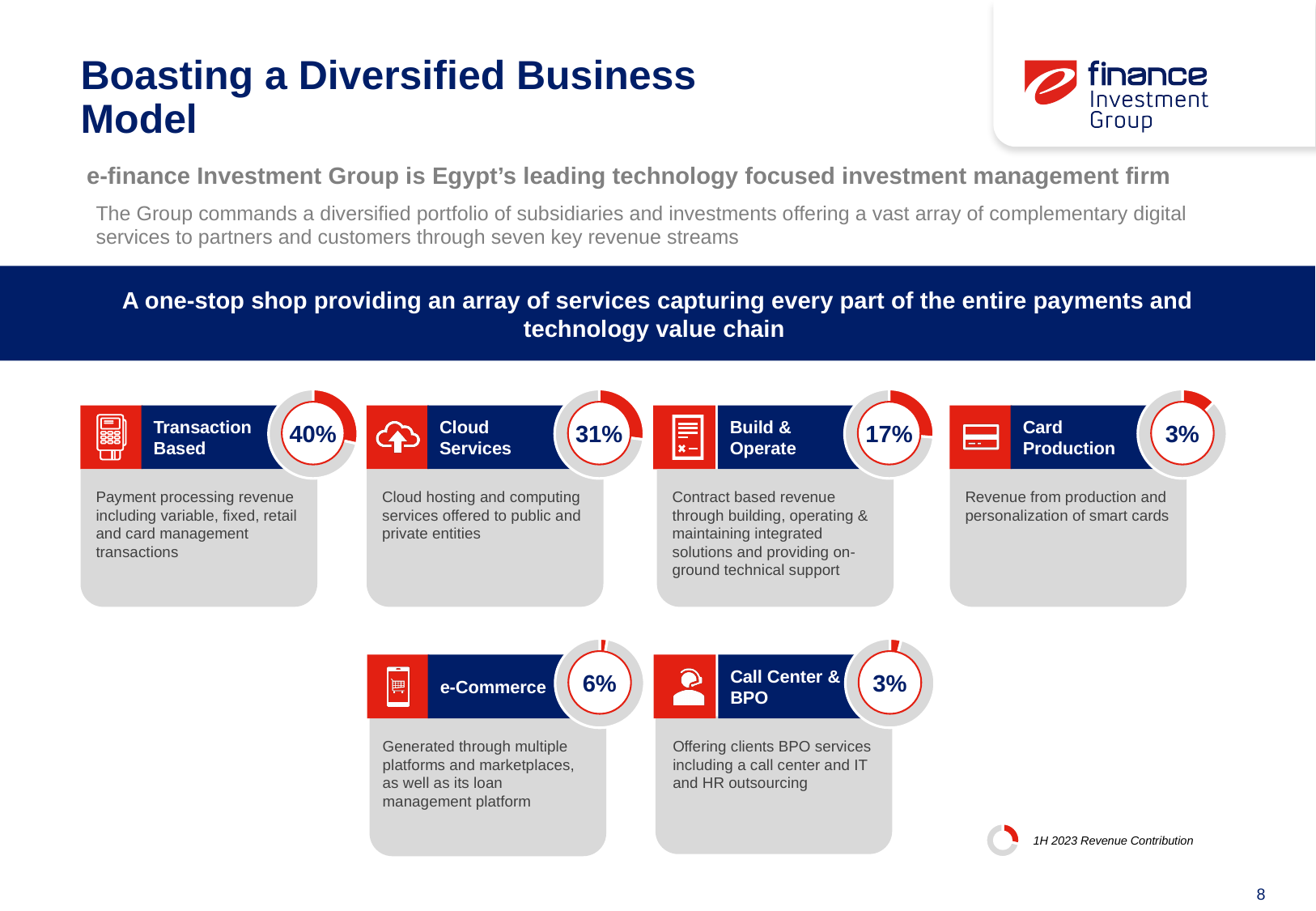
What kind of chart is used to show each revenue stream's contribution? Donut chart What is the 1H 2023 revenue contribution shown in the donut chart for e-Commerce? 6% What is the 1H 2023 revenue contribution shown in the donut chart for Cloud Services? 31% What period do the revenue contribution donut charts refer to, according to the note at the bottom right? 1H 2023 What is the difference between the revenue contribution of Transaction Based and Cloud Services? 9% What is the 1H 2023 revenue contribution shown in the donut chart for Transaction Based? 40% Which revenue stream has the highest 1H 2023 revenue contribution among the donut charts? Transaction Based Which has a larger 1H 2023 revenue contribution, Build & Operate or e-Commerce? Build & Operate How many donut charts showing revenue contribution are on the slide? 6 What is the 1H 2023 revenue contribution shown in the donut chart for Card Production? 3% Which revenue stream has the lowest 1H 2023 revenue contribution among the donut charts, other than Card Production? Call Center & BPO What is the 1H 2023 revenue contribution shown in the donut chart for Build & Operate? 17%